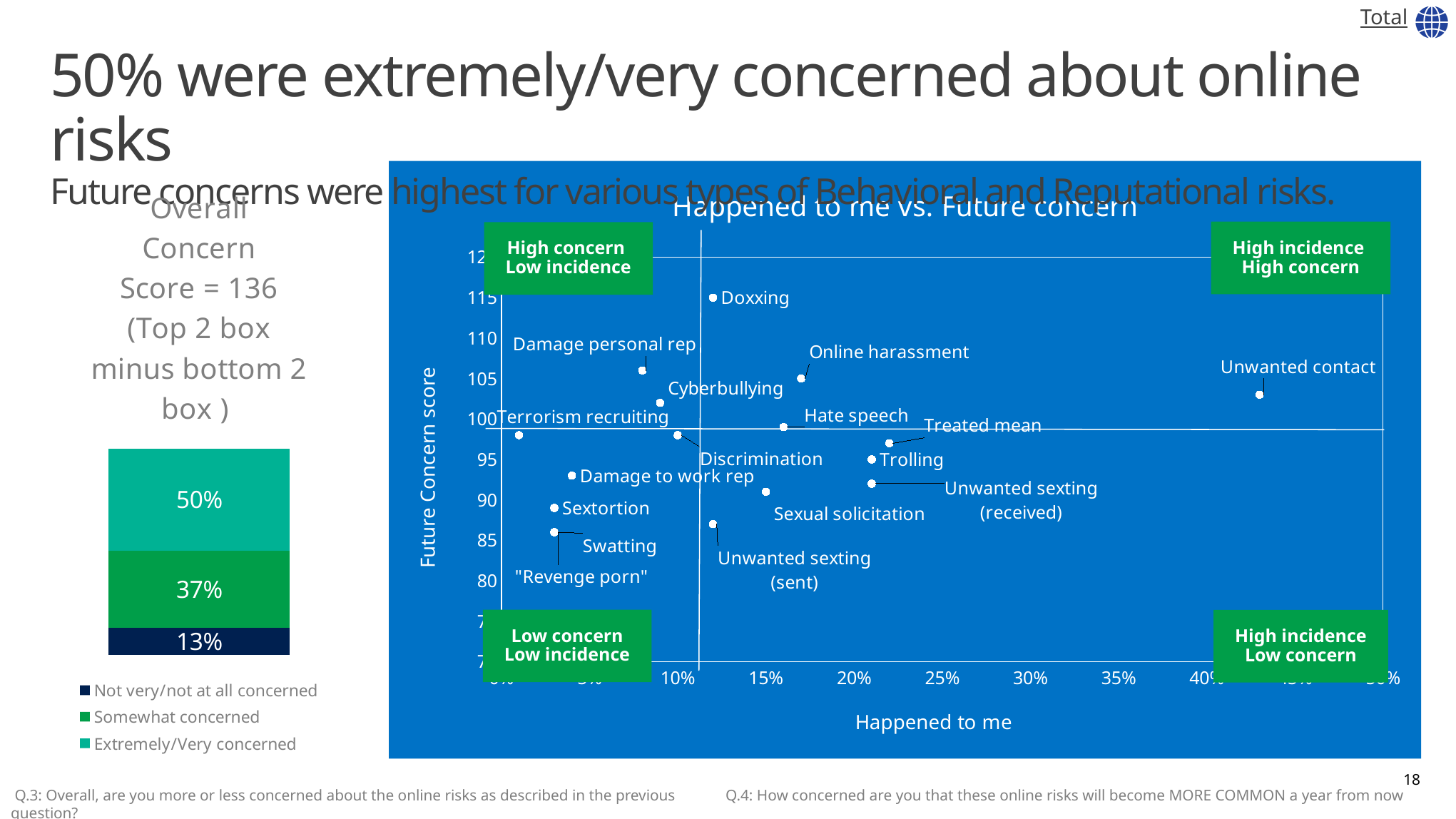
On the Overall Concern stacked bar chart, how many series does the legend list? 3 On the Overall Concern stacked bar chart, what percentage were Extremely/Very concerned? 50% On the 'Happened to me vs. Future concern' chart, which has a higher Future Concern score, Online harassment or Sextortion? Online harassment On the 'Happened to me vs. Future concern' chart, which risk has the highest Future Concern score? Doxxing On the 'Happened to me vs. Future concern' chart, is the Future Concern score for Doxxing greater or less than 110? greater On the Overall Concern stacked bar chart, which segment is the largest? Extremely/Very concerned On the 'Happened to me vs. Future concern' chart, is the 'Happened to me' value for Unwanted contact greater or less than 40%? greater On the 'Happened to me vs. Future concern' chart, which risk has the highest 'Happened to me' percentage? Unwanted contact What kind of chart is the 'Happened to me vs. Future concern' chart? Scatter chart On the Overall Concern stacked bar chart, what percentage were Somewhat concerned? 37% On the Overall Concern stacked bar chart, what percentage were Not very/not at all concerned? 13% On the Overall Concern stacked bar chart, what is the difference between the Extremely/Very concerned and Somewhat concerned shares? 13%